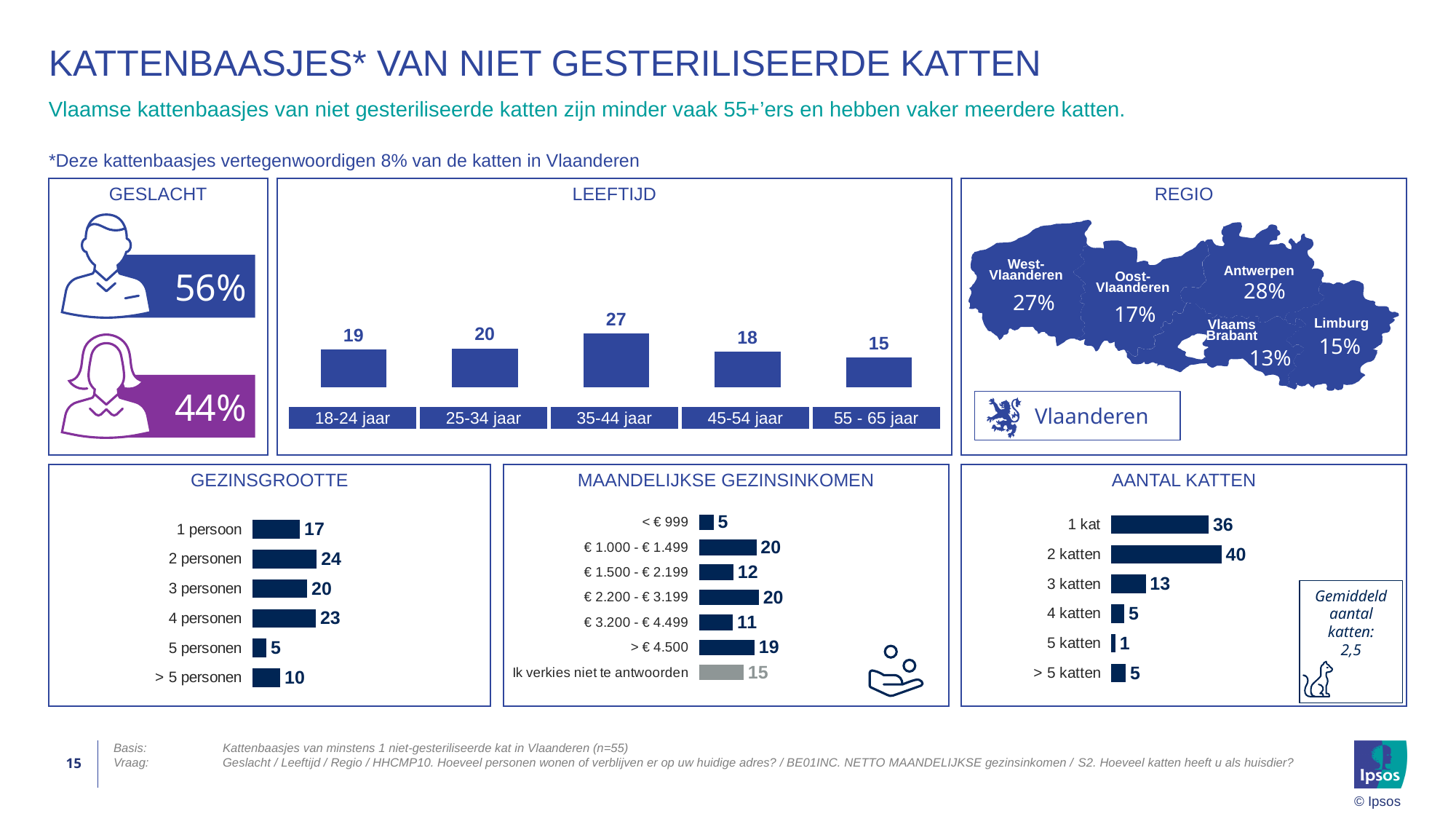
In the GEZINSGROOTTE chart, what is the value for 2 personen? 24 In the LEEFTIJD chart, which age group has the lowest value? 55 - 65 jaar In the AANTAL KATTEN chart, which category has the highest value? 2 katten In the GEZINSGROOTTE chart, what is the difference between 4 personen and > 5 personen? 13 In the LEEFTIJD chart, what is the value for 35-44 jaar? 27 In the MAANDELIJKSE GEZINSINKOMEN chart, which is larger: € 1.000 - € 1.499 or > € 4.500? € 1.000 - € 1.499 What type of chart is the LEEFTIJD chart? bar chart In the GEZINSGROOTTE chart, which category has the lowest value? 5 personen In the MAANDELIJKSE GEZINSINKOMEN chart, how many categories are shown? 7 In the MAANDELIJKSE GEZINSINKOMEN chart, what is the value for € 3.200 - € 4.499? 11 In the AANTAL KATTEN chart, what is the difference between 1 kat and 3 katten? 23 In the LEEFTIJD chart, how many age groups are shown? 5